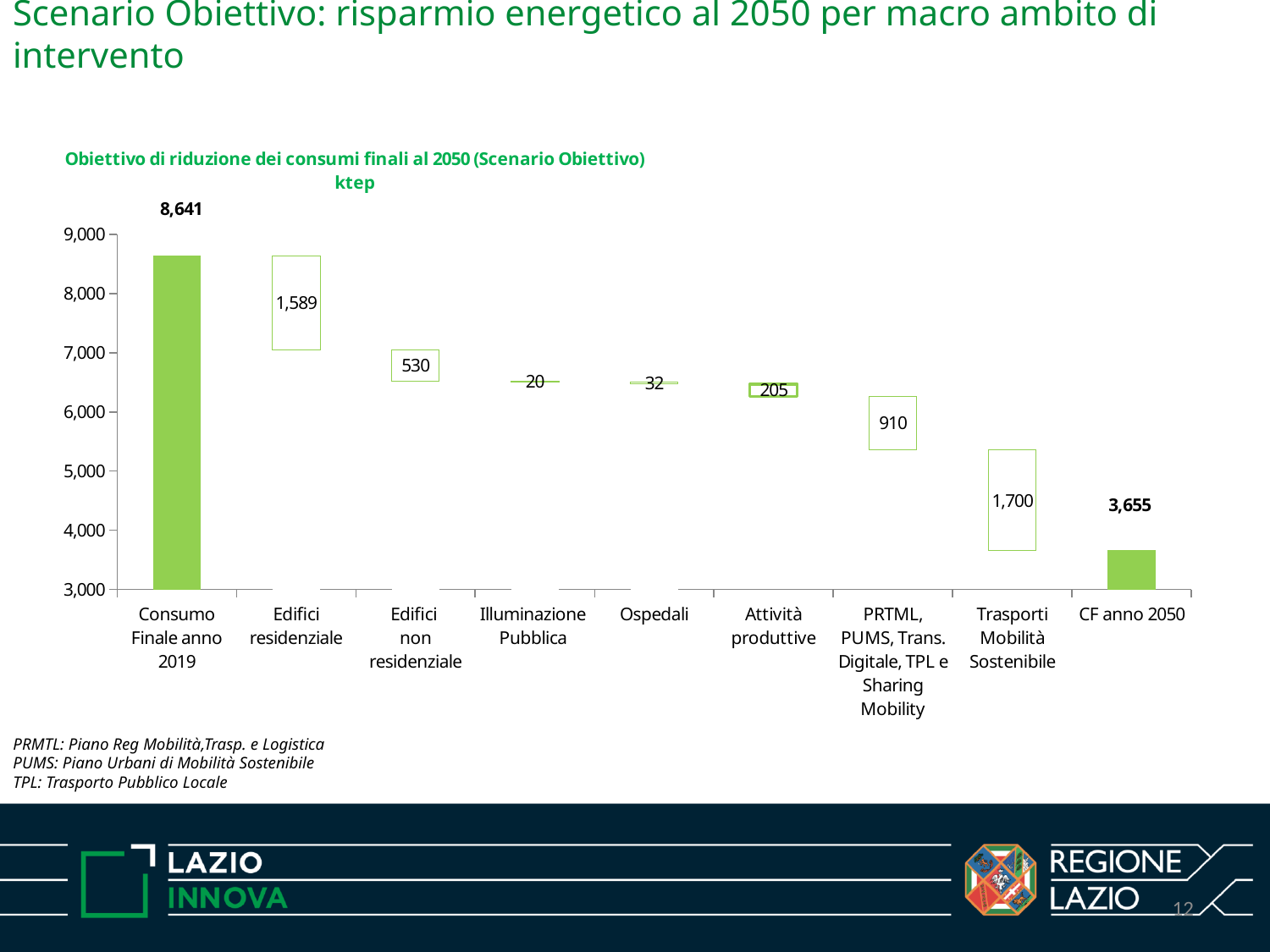
How many categories are shown on the x axis of the chart? 9 What is the value shown for Trasporti Mobilità Sostenibile? 1,700 Which is larger, the value for Ospedali or the value for Illuminazione Pubblica? Ospedali Which category has the smallest value in the chart? Illuminazione Pubblica Is the value for CF anno 2050 greater or less than 4,000? less What unit is stated under the chart title? ktep What is the difference between Consumo Finale anno 2019 and CF anno 2050? 4,986 What is the value for Consumo Finale anno 2019? 8,641 What is the value for CF anno 2050? 3,655 What is the value shown for PRTML, PUMS, Trans. Digitale, TPL e Sharing Mobility? 910 What is the value shown for Edifici residenziale? 1,589 Which category has the largest value in the chart? Consumo Finale anno 2019